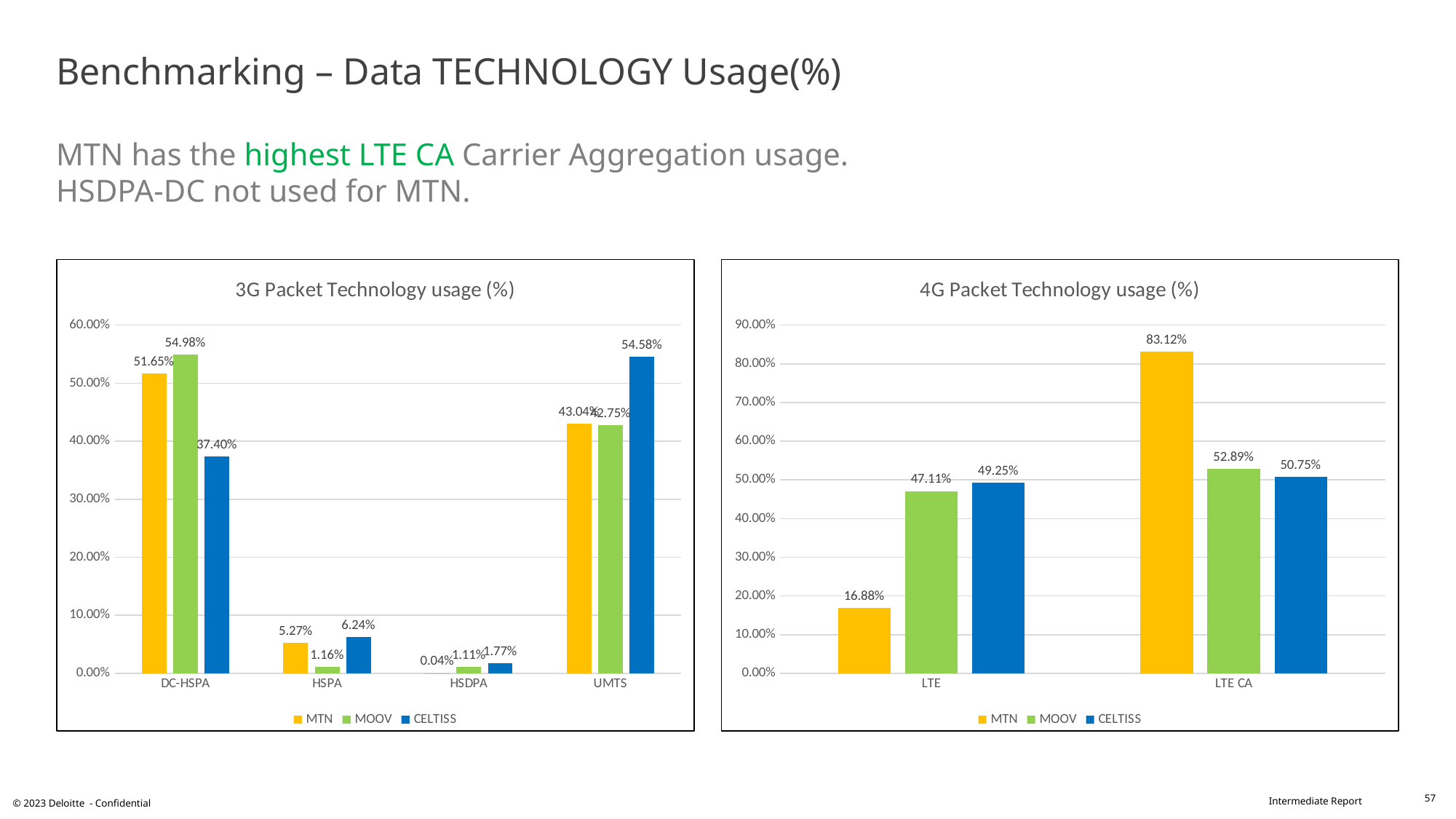
In the 3G Packet Technology usage chart, what is the value for CELTISS at UMTS? 54.58% In the 3G Packet Technology usage chart, which operator has the lowest value at DC-HSPA? CELTISS In the 3G Packet Technology usage chart, what is the value for MTN at HSDPA? 0.04% In the 3G Packet Technology usage chart, what is the difference between the MTN and CELTISS values at DC-HSPA? 14.25% In the 4G Packet Technology usage chart, which operator has the lowest value at LTE? MTN In the 3G Packet Technology usage chart, how many technology categories are shown on the x axis? 4 How many series does the legend of the 4G Packet Technology usage chart list? 3 In the 4G Packet Technology usage chart, what is the difference between the MTN values at LTE CA and LTE? 66.24% In the 4G Packet Technology usage chart, what is the value for MTN at LTE CA? 83.12% In the 4G Packet Technology usage chart, what is the value for MOOV at LTE? 47.11% In the 3G Packet Technology usage chart, what is the value for MOOV at DC-HSPA? 54.98% In the 3G Packet Technology usage chart, which operator has the highest value at HSPA? CELTISS